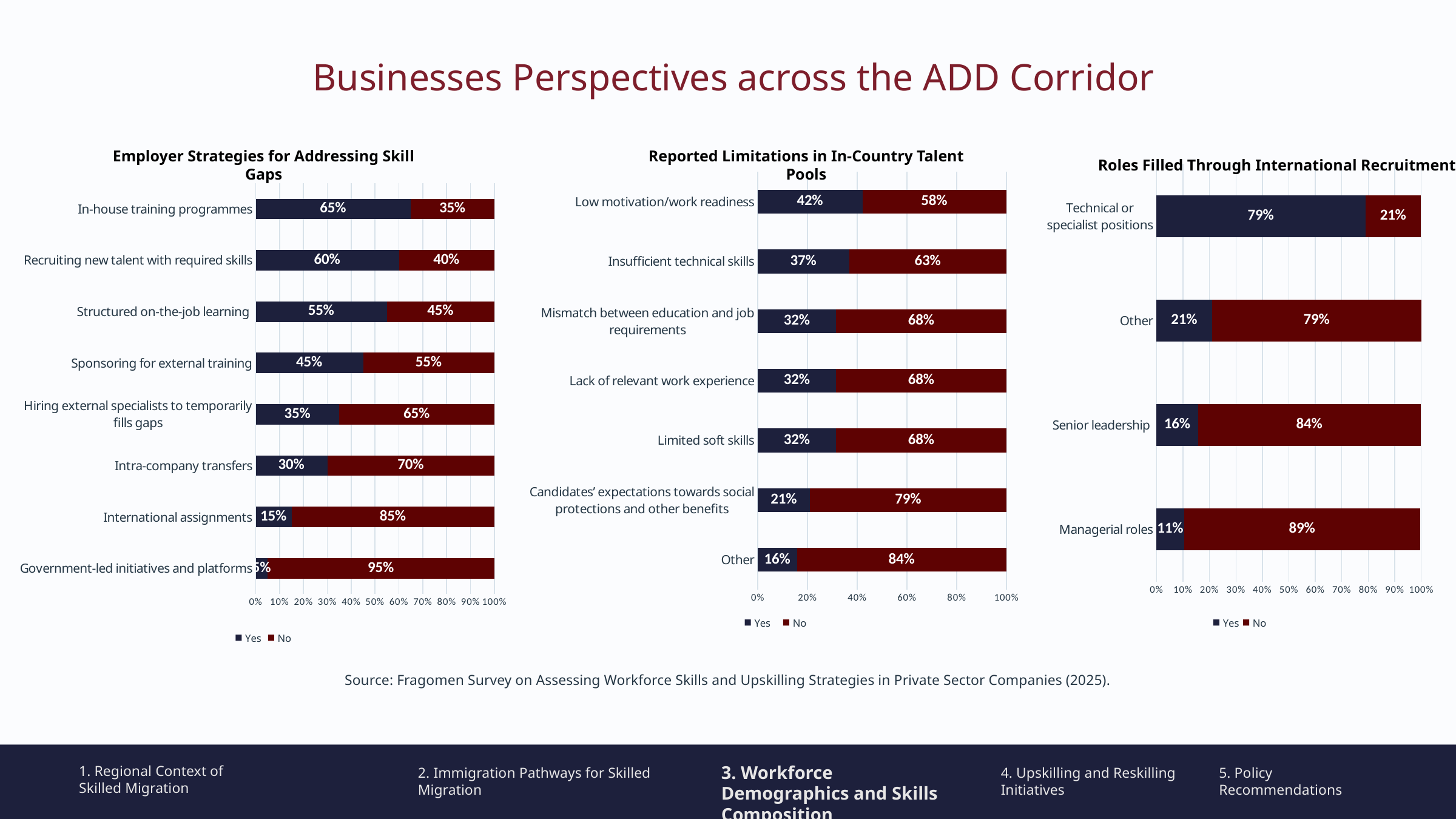
In the 'Reported Limitations in In-Country Talent Pools' chart, how many limitations are listed? 7 In the 'Roles Filled Through International Recruitment' chart, which role has the highest Yes value? Technical or specialist positions In the 'Employer Strategies for Addressing Skill Gaps' chart, what is the difference between the Yes values for Recruiting new talent with required skills and Intra-company transfers? 30% In the 'Reported Limitations in In-Country Talent Pools' chart, what is the Yes value for Low motivation/work readiness? 42% How many series does the legend of the 'Roles Filled Through International Recruitment' chart list? 2 In the 'Roles Filled Through International Recruitment' chart, what is the Yes value for Senior leadership? 16% In the 'Reported Limitations in In-Country Talent Pools' chart, is the Yes value for Insufficient technical skills larger or smaller than the Yes value for Limited soft skills? larger In the 'Employer Strategies for Addressing Skill Gaps' chart, what is the Yes value for In-house training programmes? 65% In the 'Employer Strategies for Addressing Skill Gaps' chart, which strategy has the highest Yes value? In-house training programmes In the 'Reported Limitations in In-Country Talent Pools' chart, which limitation has the lowest Yes value? Other In the 'Employer Strategies for Addressing Skill Gaps' chart, how many strategies are listed? 8 In the 'Employer Strategies for Addressing Skill Gaps' chart, what is the No value for International assignments? 85%